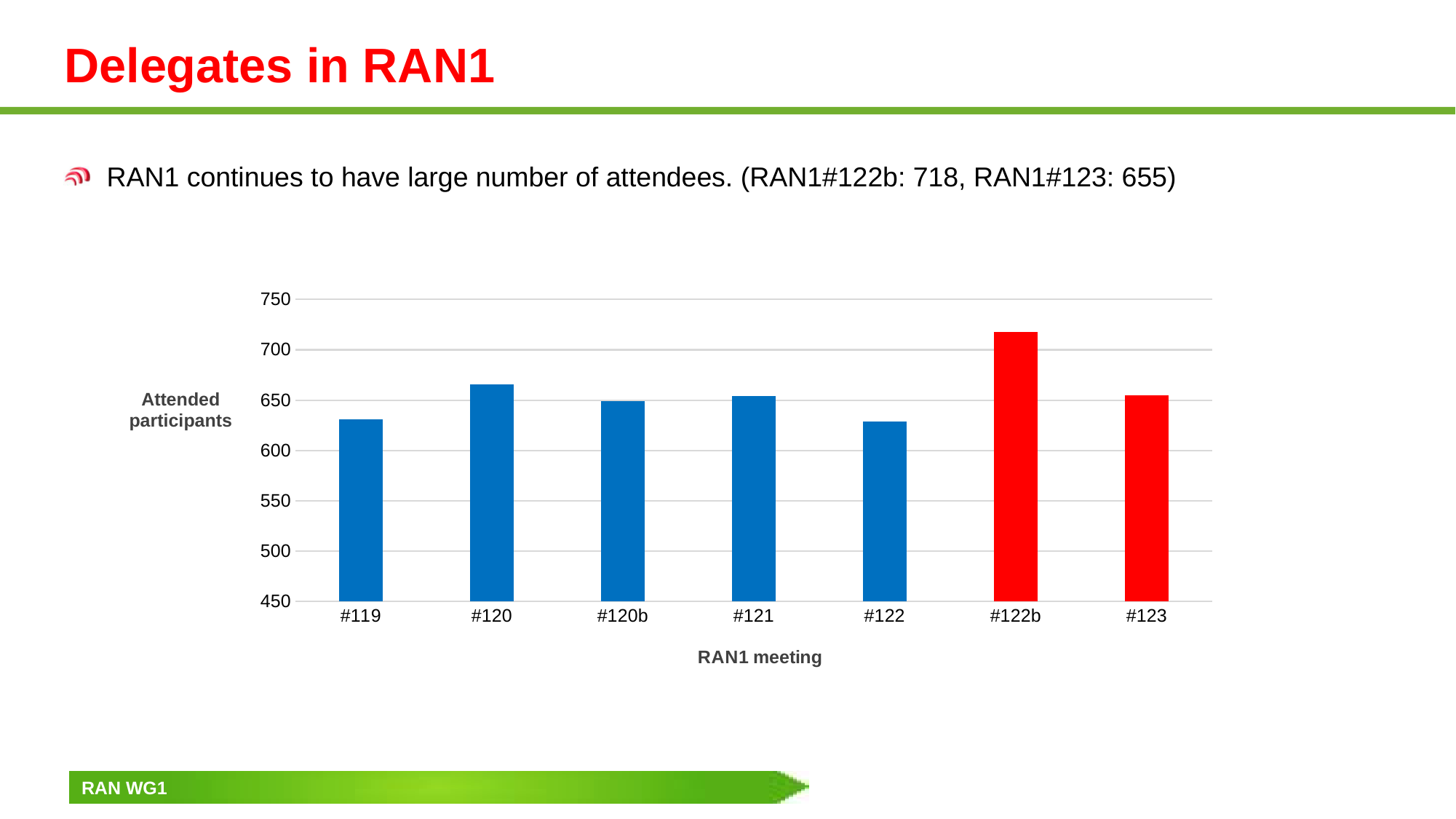
Which meeting had more attended participants, #120 or #119? #120 Which RAN1 meeting has the highest number of attended participants? #122b Is the value for #120 greater or less than 650? greater What is the label of the vertical axis of the chart? Attended participants Is the value for #119 greater or less than 650? less How many attended participants are shown for RAN1#123? 655 What type of chart is shown on the slide? Bar chart How many attended participants are shown for RAN1#122b? 718 Which meeting had more attended participants, #122b or #123? #122b Is the value for #122 greater or less than 650? less What is the difference in attended participants between RAN1#122b and RAN1#123? 63 How many RAN1 meetings are shown on the x axis of the chart? 7